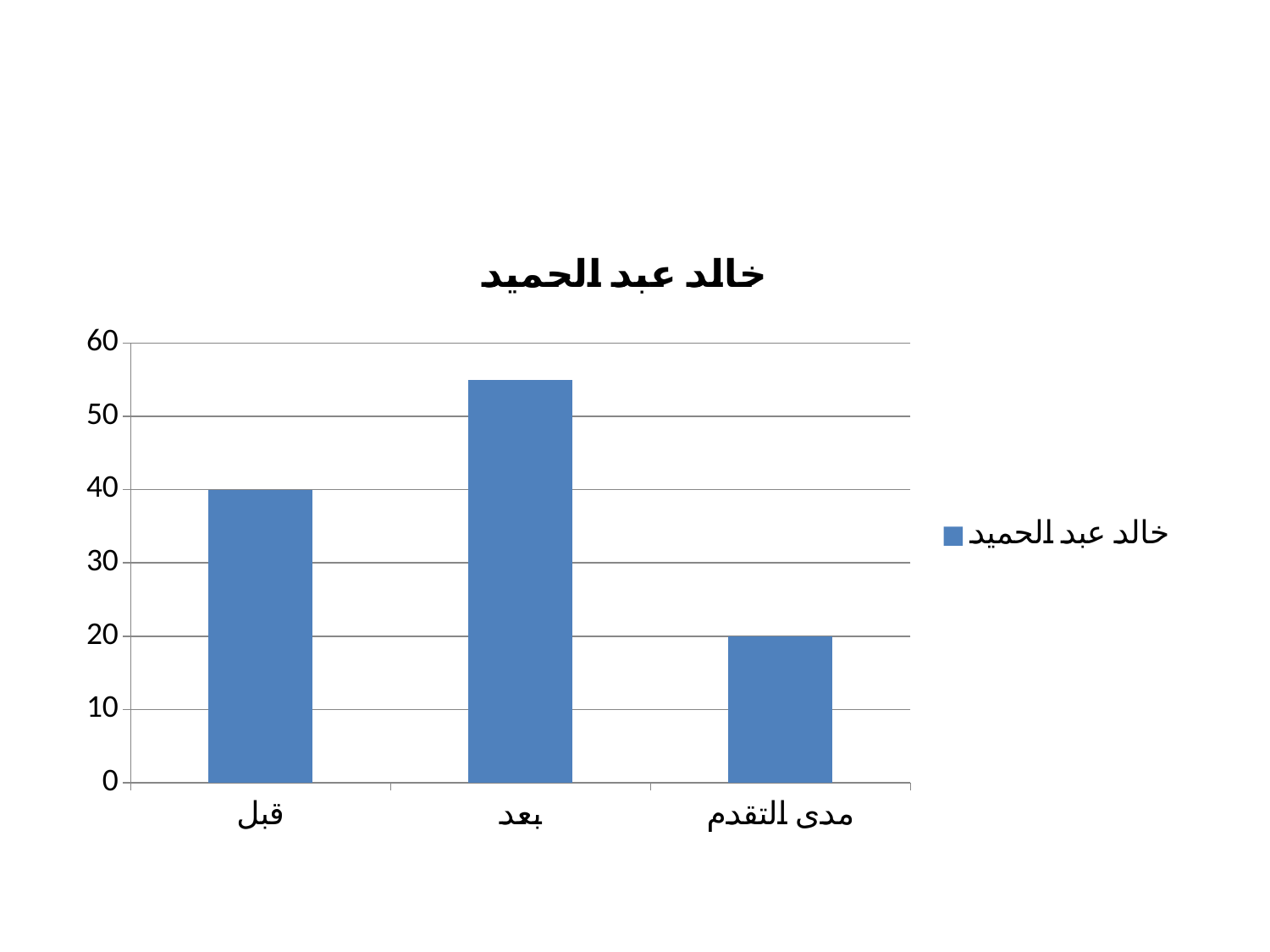
Is the value for مدى التقدم greater or less than 30? less What kind of chart is shown? bar chart What is the difference between the values for قبل and مدى التقدم? 20 What is the title of the chart? خالد عبد الحميد What is the value for قبل? 40 How many series does the legend list? 1 How many categories are shown on the x axis? 3 Which category has the lowest value? مدى التقدم Which is larger, the value for قبل or the value for بعد? بعد What is the value for مدى التقدم? 20 Which category has the highest value? بعد Is the value for بعد greater or less than 50? greater